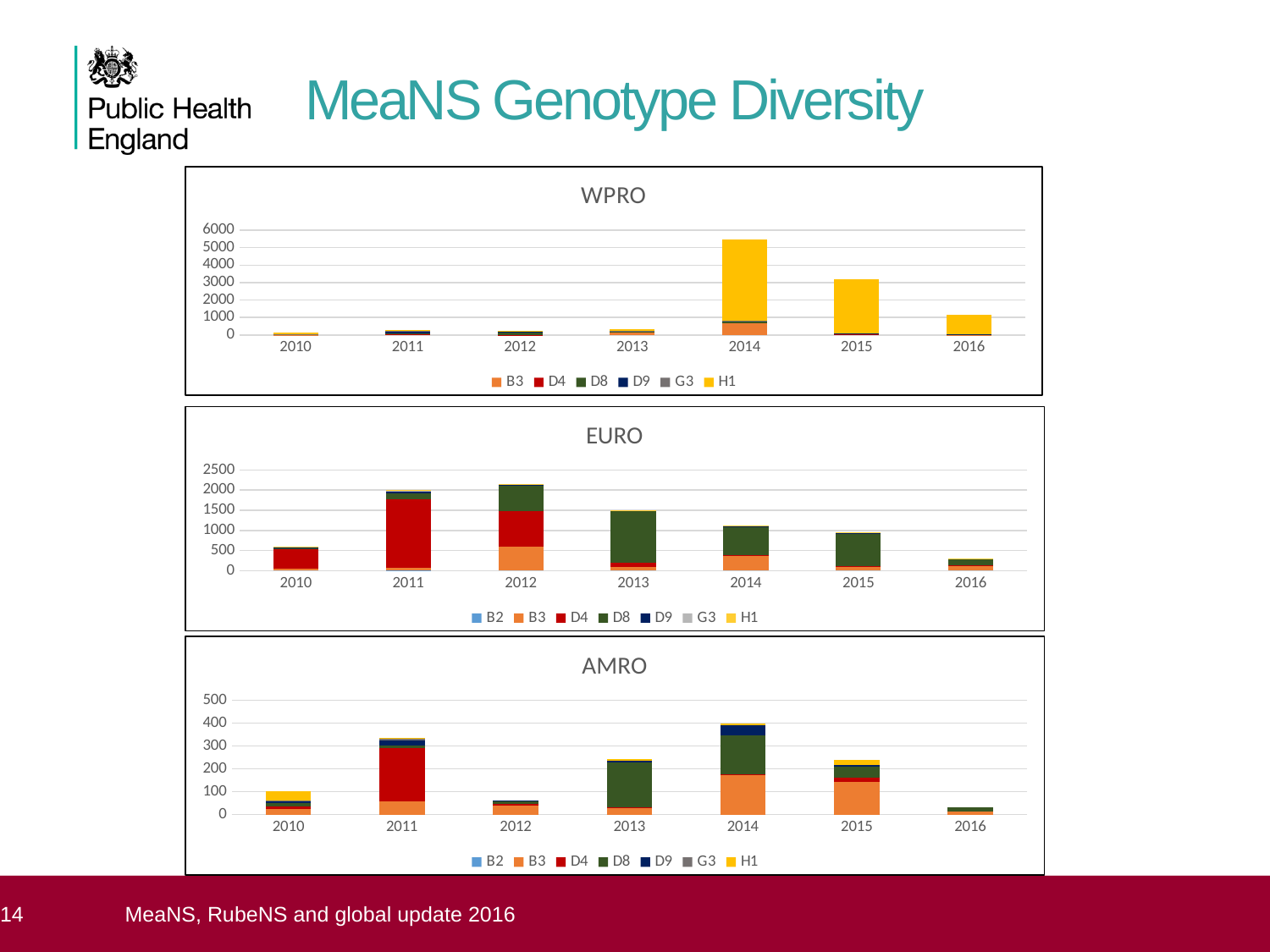
In the AMRO chart, is the total for 2012 greater or less than 100? less How many years are shown on the x axis of the EURO chart? 7 How many series does the legend of the AMRO chart list? 7 In the EURO chart, which year has the lowest total? 2016 In the WPRO chart, is the total for 2014 greater or less than 5000? greater In the EURO chart, which year has the larger total, 2013 or 2014? 2013 What kind of chart is the WPRO chart? Stacked bar chart How many series does the legend of the WPRO chart list? 6 In the AMRO chart, which year has the highest total? 2014 In the WPRO chart, which year has the highest total? 2014 In the EURO chart, is the total for 2013 greater or less than 1000? greater In the WPRO chart, do the totals rise or fall from 2014 to 2016? fall